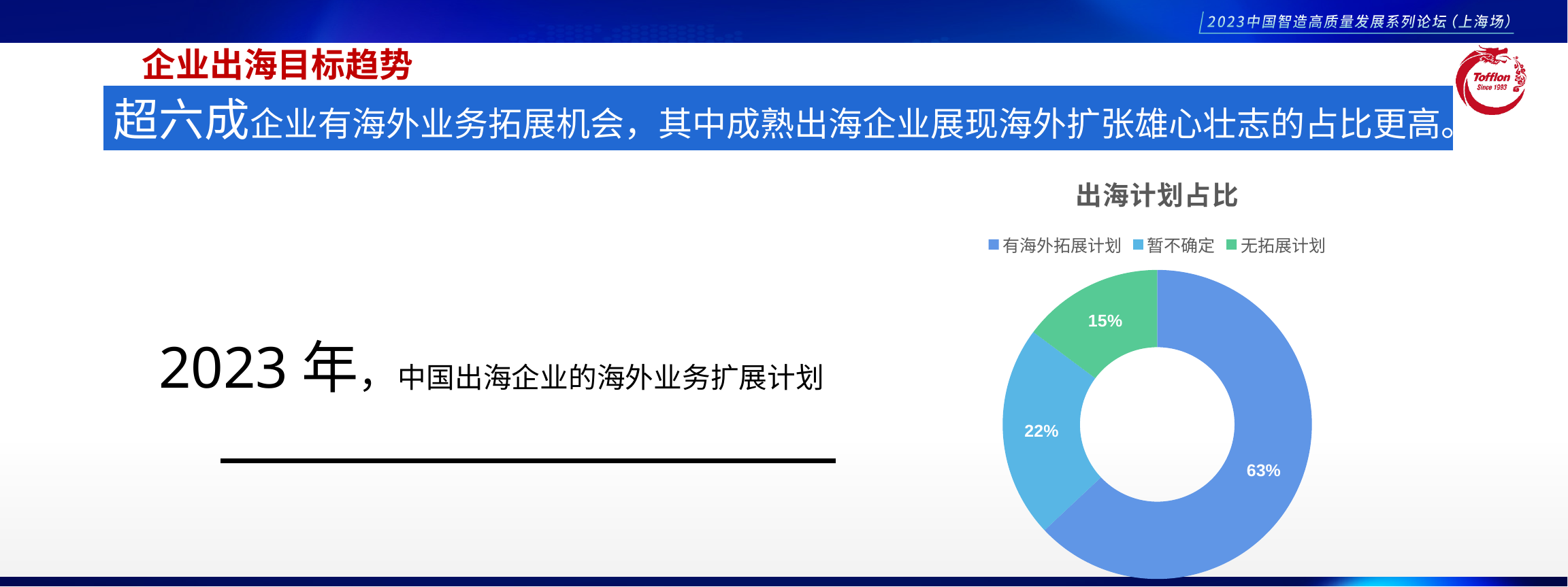
What is the difference between the shares of 暂不确定 and 无拓展计划? 7% What colour represents 无拓展计划 in the chart? Green What is the difference between the shares of 有海外拓展计划 and 暂不确定? 41% How many categories are shown in the 出海计划占比 chart? 3 Which category has the largest share in the 出海计划占比 chart? 有海外拓展计划 What is the share for 有海外拓展计划 in the 出海计划占比 chart? 63% What is the share for 暂不确定 in the 出海计划占比 chart? 22% Which category has the smallest share in the 出海计划占比 chart? 无拓展计划 What kind of chart is the 出海计划占比 chart? Doughnut (pie) chart What is the title of the chart on the slide? 出海计划占比 Which is larger, the share of 暂不确定 or the share of 无拓展计划? 暂不确定 What is the share for 无拓展计划 in the 出海计划占比 chart? 15%